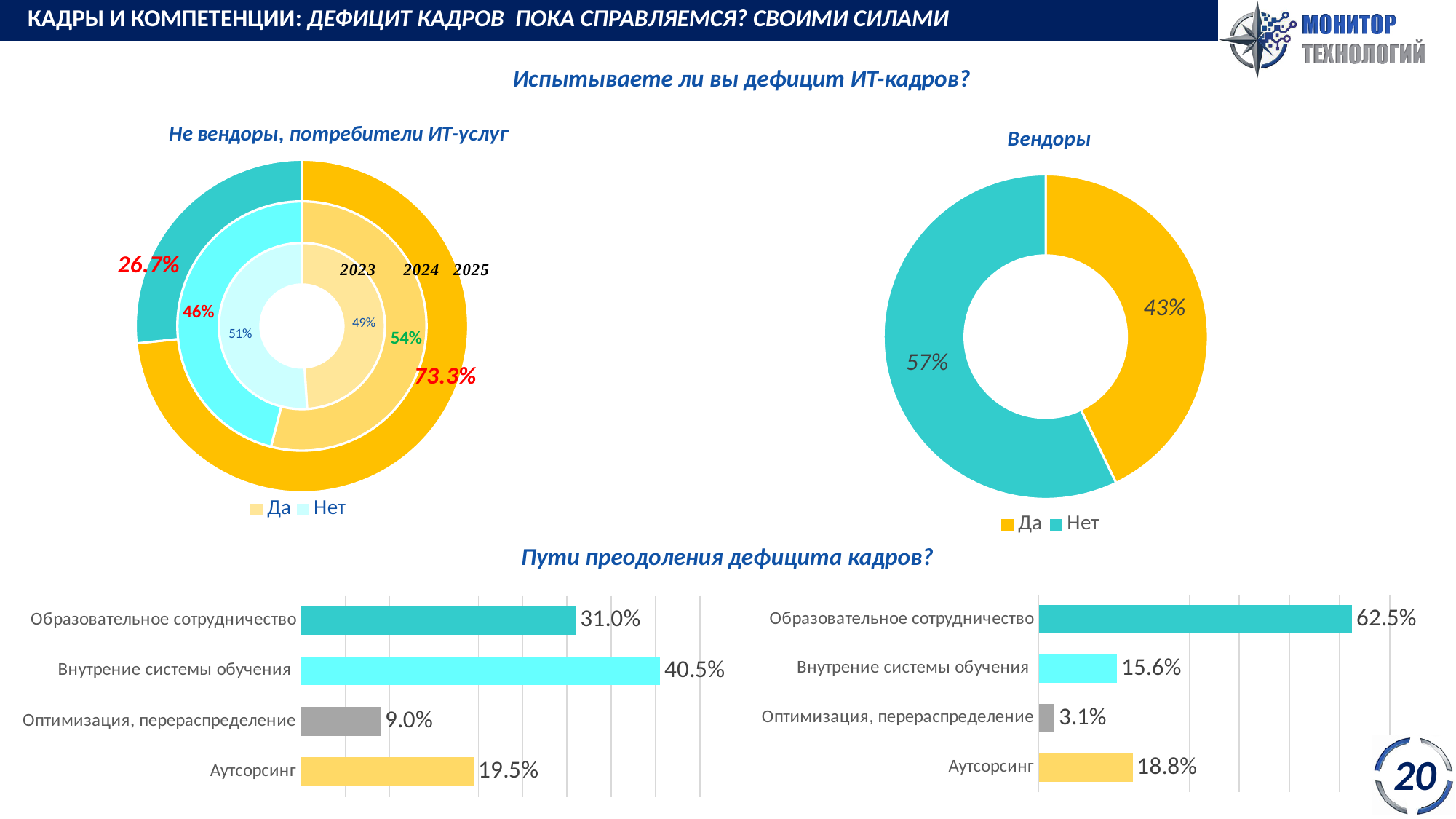
In the 'Не вендоры, потребители ИТ-услуг' chart, what is the 'Нет' share for 2023? 51% In the 'Не вендоры, потребители ИТ-услуг' chart, how many years (rings) are shown? 3 In the bottom-left bar chart under 'Пути преодоления дефицита кадров?', what is the value for 'Внутрение системы обучения'? 40.5% In the 'Вендоры' donut chart, what share of respondents answered 'Да'? 43% In the 'Вендоры' donut chart, which answer has the larger share, 'Да' or 'Нет'? Нет In the 'Не вендоры, потребители ИТ-услуг' chart, what is the 'Да' share for 2024? 54% In the 'Не вендоры, потребители ИТ-услуг' chart, what is the 'Нет' share in the outer 2025 ring? 26.7% In the 'Вендоры' donut chart, what share of respondents answered 'Нет'? 57% In the bottom-right bar chart under 'Пути преодоления дефицита кадров?', which category has the highest value? Образовательное сотрудничество In the 'Не вендоры, потребители ИТ-услуг' chart, what is the 'Да' share in the outer 2025 ring? 73.3% In the bottom-right bar chart under 'Пути преодоления дефицита кадров?', what is the difference between 'Аутсорсинг' and 'Внутрение системы обучения'? 3.2% In the bottom-left bar chart under 'Пути преодоления дефицита кадров?', which category has the lowest value? Оптимизация, перераспределение